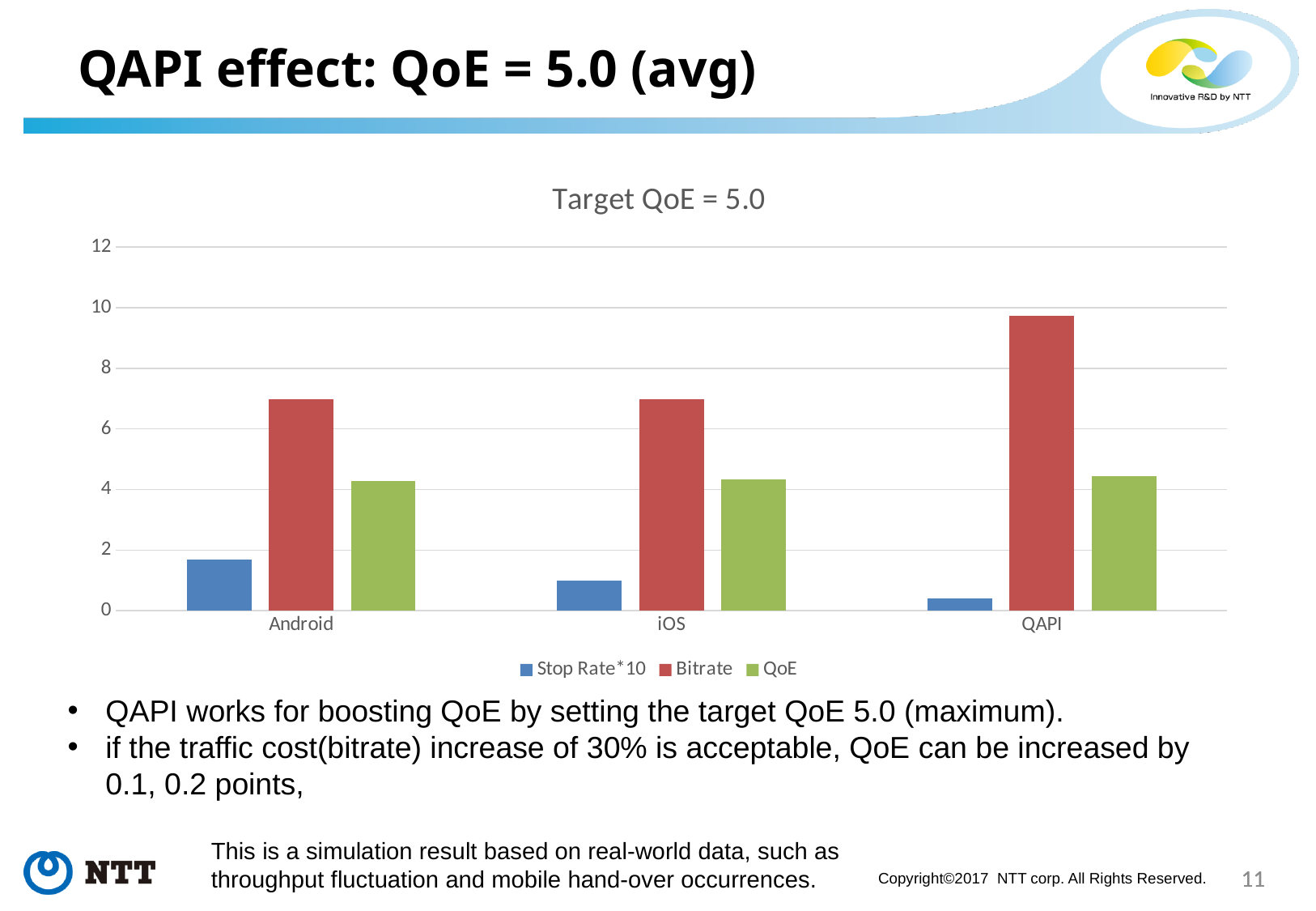
Which category has the highest Bitrate value? QAPI Is the Stop Rate*10 value for Android greater or less than 2? less What type of chart is shown on the slide? bar chart Which category has the highest Stop Rate*10 value? Android Which category has the lowest Stop Rate*10 value? QAPI Which is larger, the Stop Rate*10 value for Android or for iOS? Android Does the Stop Rate*10 series rise or fall from Android to QAPI along the x axis? fall How many series does the legend list? 3 How many categories are shown on the x axis? 3 Is the Bitrate value for QAPI greater or less than 8? greater What is the title of the chart? Target QoE = 5.0 Is the QoE value for Android greater or less than 4? greater